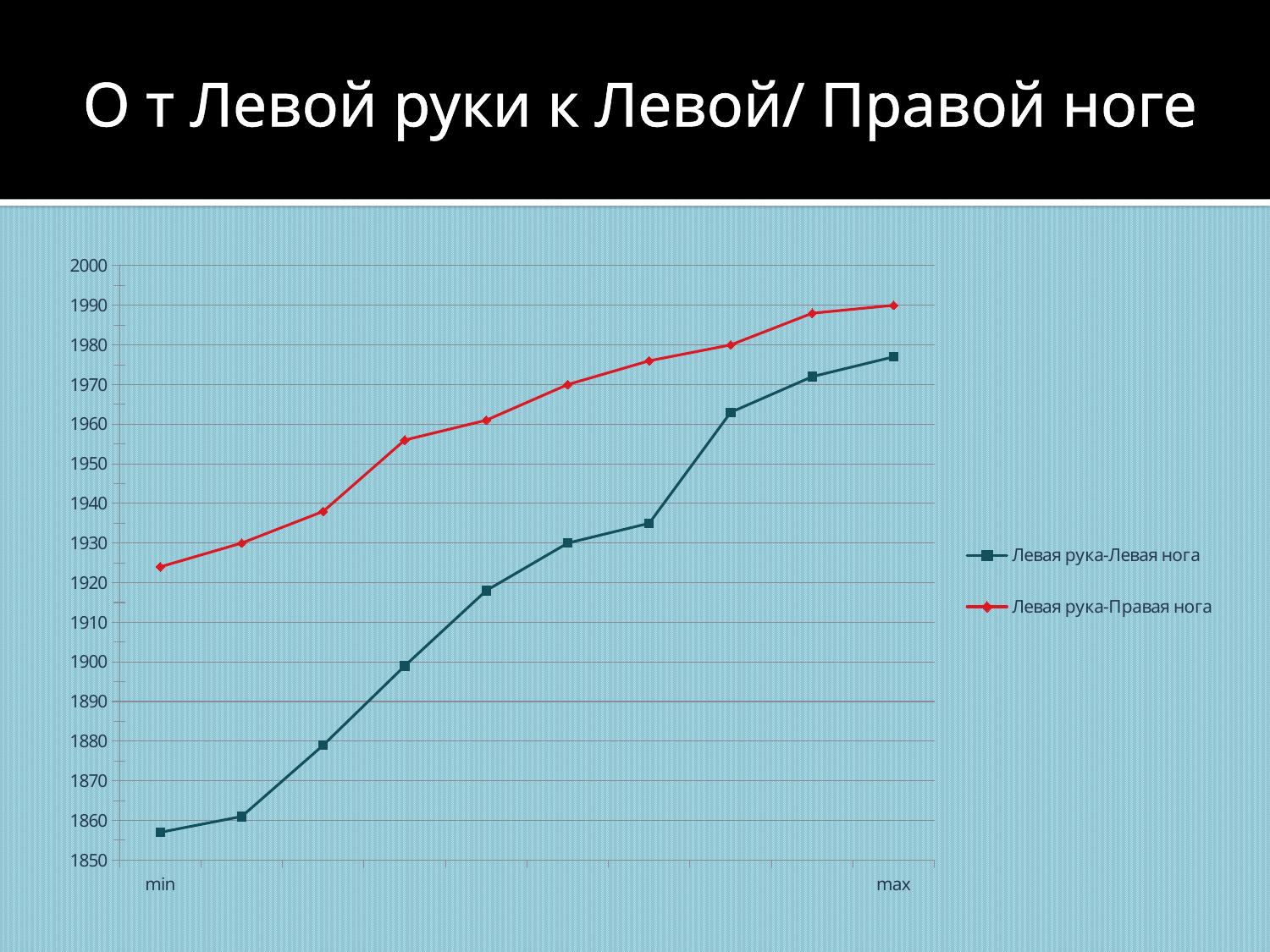
Is the value for "Левая рука-Левая нога" at "max" greater or less than 1980? less How many data points does the "Левая рука-Левая нога" series have? 10 At the "max" point, which series has the larger value, "Левая рука-Левая нога" or "Левая рука-Правая нога"? Левая рука-Правая нога How many series does the legend list? 2 Is the value for "Левая рука-Правая нога" at "max" greater or less than 1980? greater What colour is the line for the "Левая рука-Правая нога" series? Red Is the value for "Левая рука-Левая нога" at "min" greater or less than 1860? less At the "min" point, which series has the larger value, "Левая рука-Левая нога" or "Левая рука-Правая нога"? Левая рука-Правая нога Do the values of the "Левая рука-Правая нога" series rise or fall from min to max along the x axis? Rise Do the values of the "Левая рука-Левая нога" series rise or fall from min to max along the x axis? Rise What kind of chart is shown on the slide? Line chart